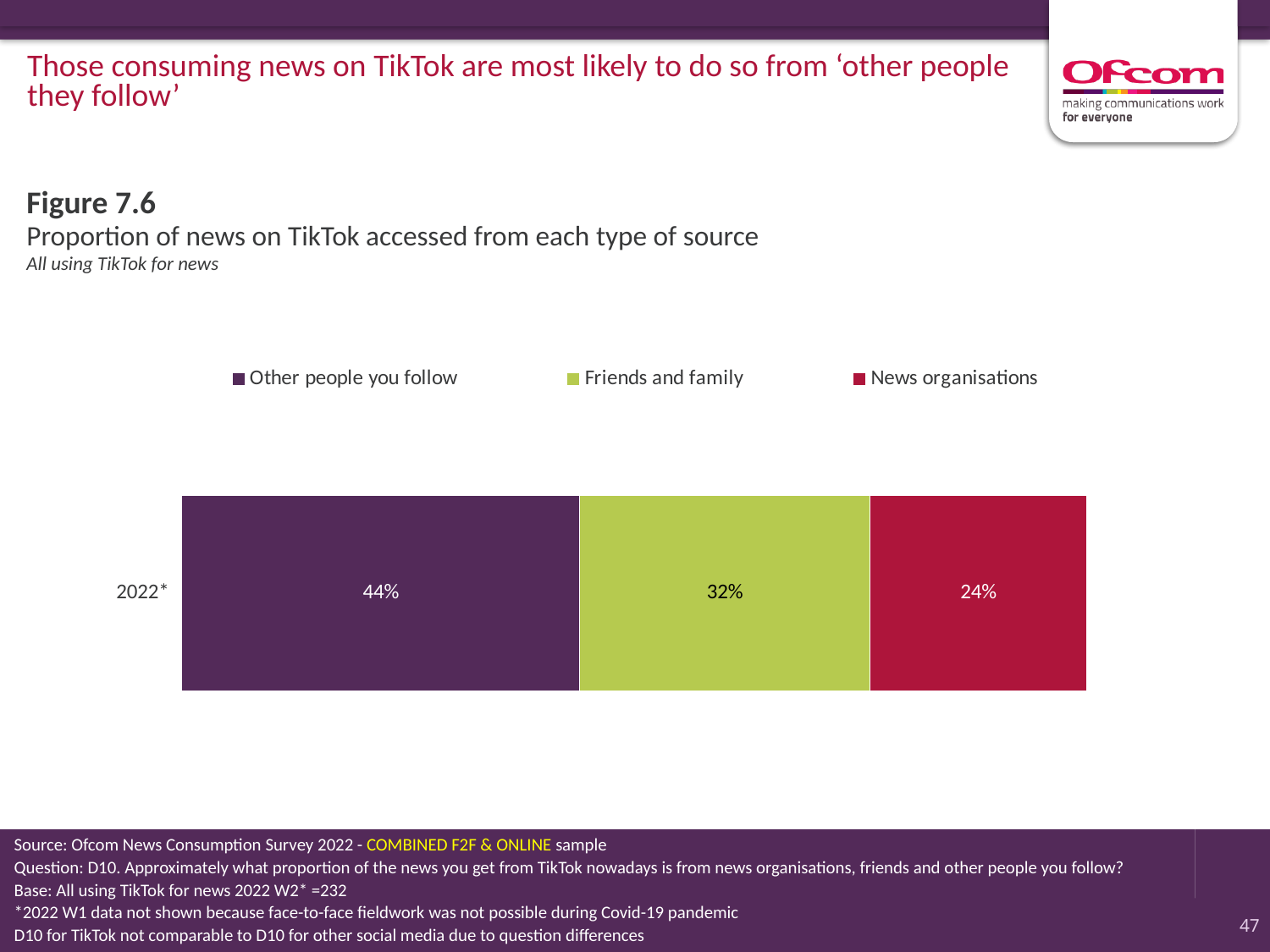
What is the total of the three segments in the 2022* bar? 100% Which year label is shown on the bar in the chart? 2022* Which source type accounts for the smallest share of news accessed on TikTok? News organisations What percentage of news on TikTok is accessed from 'Friends and family'? 32% What percentage of news on TikTok is accessed from 'News organisations'? 24% Which is larger: the share for 'Friends and family' or the share for 'News organisations'? Friends and family How many series does the legend list? 3 What kind of chart is shown on the slide? Stacked bar chart What percentage of news on TikTok is accessed from 'Other people you follow'? 44% Which source type accounts for the largest share of news accessed on TikTok? Other people you follow What is the difference in percentage points between 'Friends and family' and 'News organisations'? 8 What is the difference in percentage points between 'Other people you follow' and 'News organisations'? 20